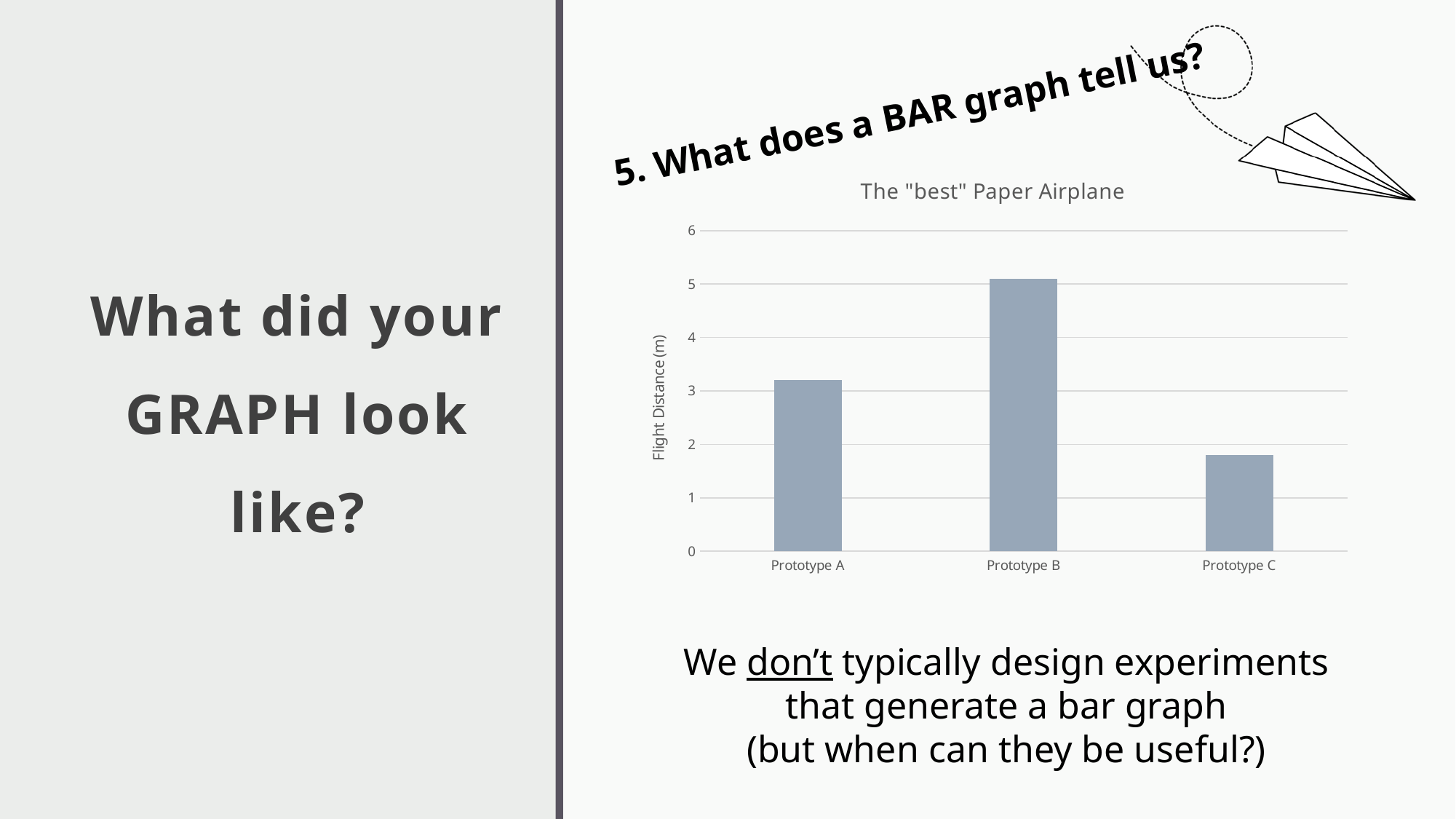
How many prototypes are plotted in the chart? 3 Is the flight distance for Prototype A greater or less than 3? greater What is the title of the chart? The "best" Paper Airplane Is the flight distance for Prototype A greater or less than 4? less Is the flight distance for Prototype C greater or less than 2? less Which prototype has the highest flight distance? Prototype B Which has a larger flight distance, Prototype B or Prototype A? Prototype B What kind of chart is shown on the slide? bar chart What is the label on the vertical axis of the chart? Flight Distance (m) Which prototype has the lowest flight distance? Prototype C Which has a larger flight distance, Prototype A or Prototype C? Prototype A